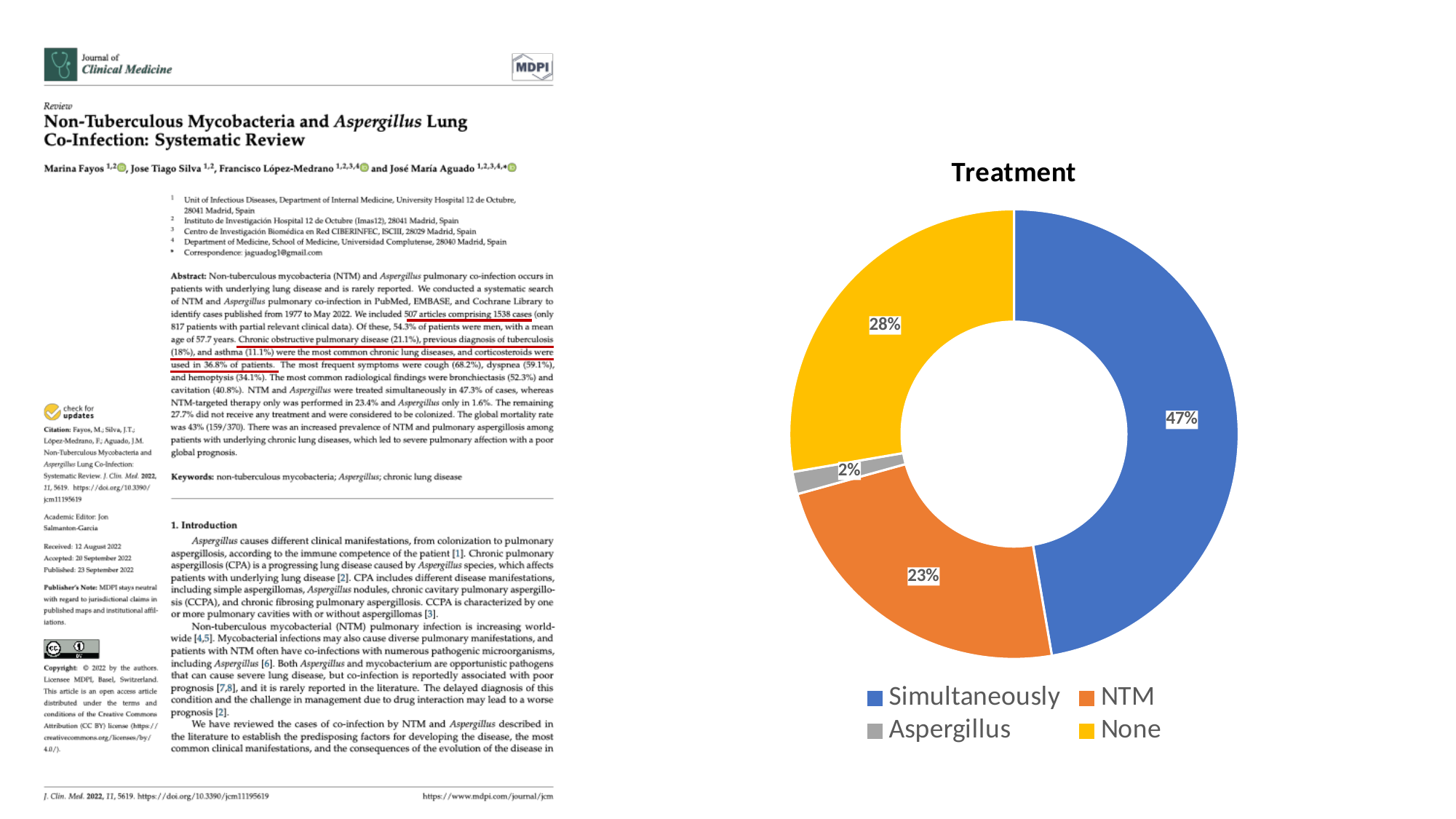
What colour represents the None category? Yellow Which is larger, the share for None or the share for NTM? None What percentage of cases were treated Simultaneously? 47% What is the difference in percentage points between Simultaneously and NTM? 24 How many categories does the legend list? 4 What percentage of cases received NTM treatment? 23% What percentage of cases received no treatment (None)? 28% What is the title of the chart? Treatment What percentage of cases received Aspergillus treatment? 2% Which treatment category has the largest share? Simultaneously What kind of chart is shown on the slide? Pie chart (doughnut) Which treatment category has the smallest share? Aspergillus